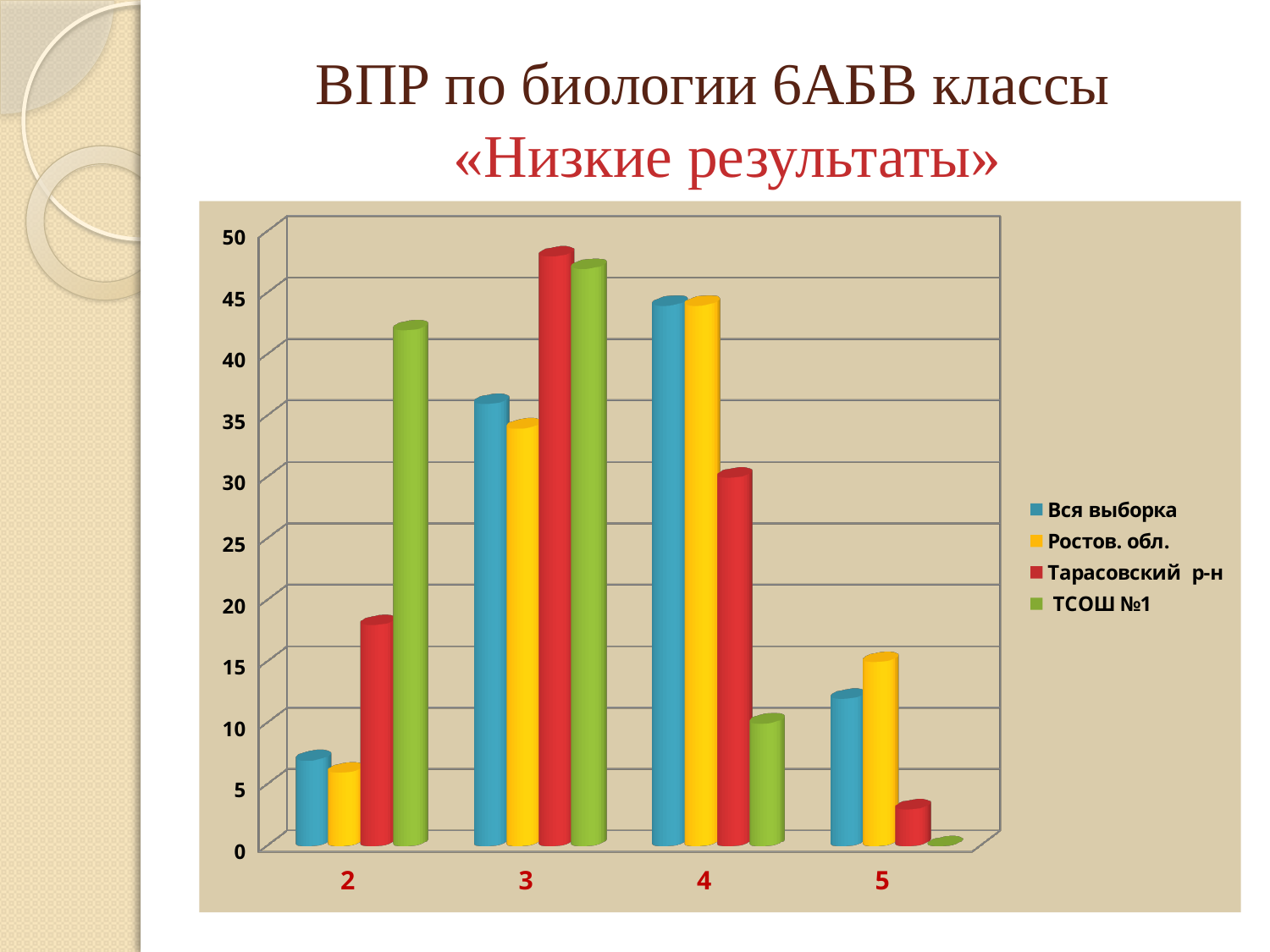
How many series does the legend list? 4 Is the value for Ростов. обл. in category 5 greater or less than 10? greater Which series has the lowest value in category 5? ТСОШ №1 Which series has the highest value in category 2? ТСОШ №1 What kind of chart is shown on the slide? bar chart Which series is represented by the green bars? ТСОШ №1 Is the value for Тарасовский р-н in category 2 greater or less than 20? less How many categories are shown on the x axis? 4 In category 2, which is larger: the value for Тарасовский р-н or the value for Вся выборка? Тарасовский р-н Is the value for ТСОШ №1 in category 4 greater or less than 15? less